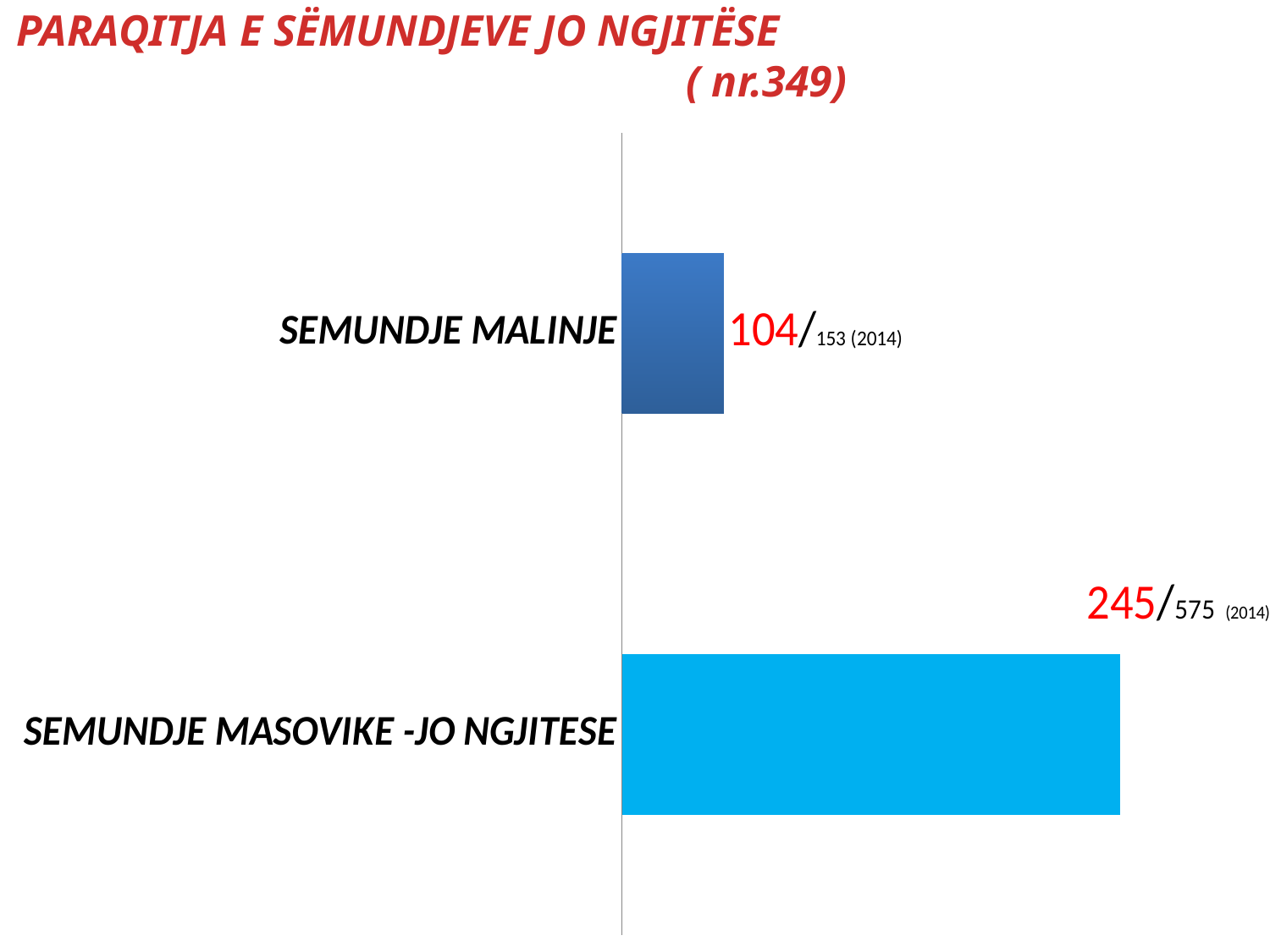
Which is larger, the value for SEMUNDJE MALINJE or the value for SEMUNDJE MASOVIKE -JO NGJITESE? SEMUNDJE MASOVIKE -JO NGJITESE Which category has the lowest value? SEMUNDJE MALINJE Which category has the highest value? SEMUNDJE MASOVIKE -JO NGJITESE What is the value shown for SEMUNDJE MASOVIKE -JO NGJITESE? 245 What is the difference between the values for SEMUNDJE MASOVIKE -JO NGJITESE and SEMUNDJE MALINJE? 141 What 2014 figure is printed next to the SEMUNDJE MALINJE bar? 153 What kind of chart is shown on the slide? Bar chart What is the value shown for SEMUNDJE MALINJE? 104 What 2014 figure is printed next to the SEMUNDJE MASOVIKE -JO NGJITESE bar? 575 What is the sum of the two values plotted in the chart? 349 What number is given in parentheses in the chart title? nr.349 How many categories are shown in the chart? 2